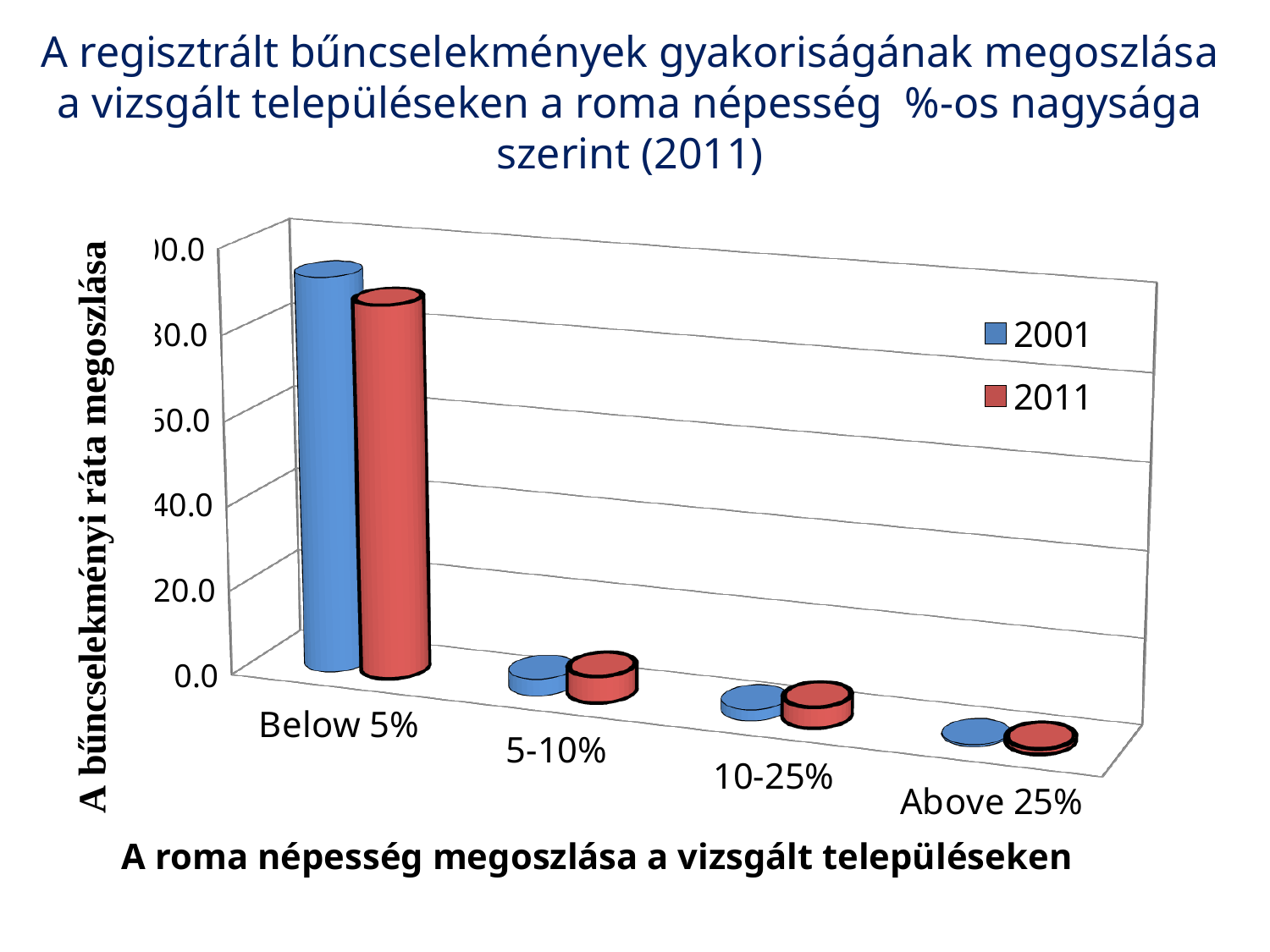
Is the value for Below 5% in the 2011 series greater or less than 60? greater How many series does the legend list? 2 Do the values for the 2001 series rise or fall moving from Below 5% to Above 25% along the x axis? fall Which category has the lowest value for the 2001 series? Above 25% Is the value for Below 5% in the 2001 series greater or less than 60? greater Which category has the highest value for the 2011 series? Below 5% What kind of chart is shown on the slide? bar chart How many categories are shown on the x axis? 4 Which is larger for the 2011 series: the value for Below 5% or the value for 10-25%? Below 5% What is the title of the x axis? A roma népesség megoszlása a vizsgált településeken Which series are listed in the legend? 2001 and 2011 Is the value for 5-10% in the 2011 series greater or less than 20? less